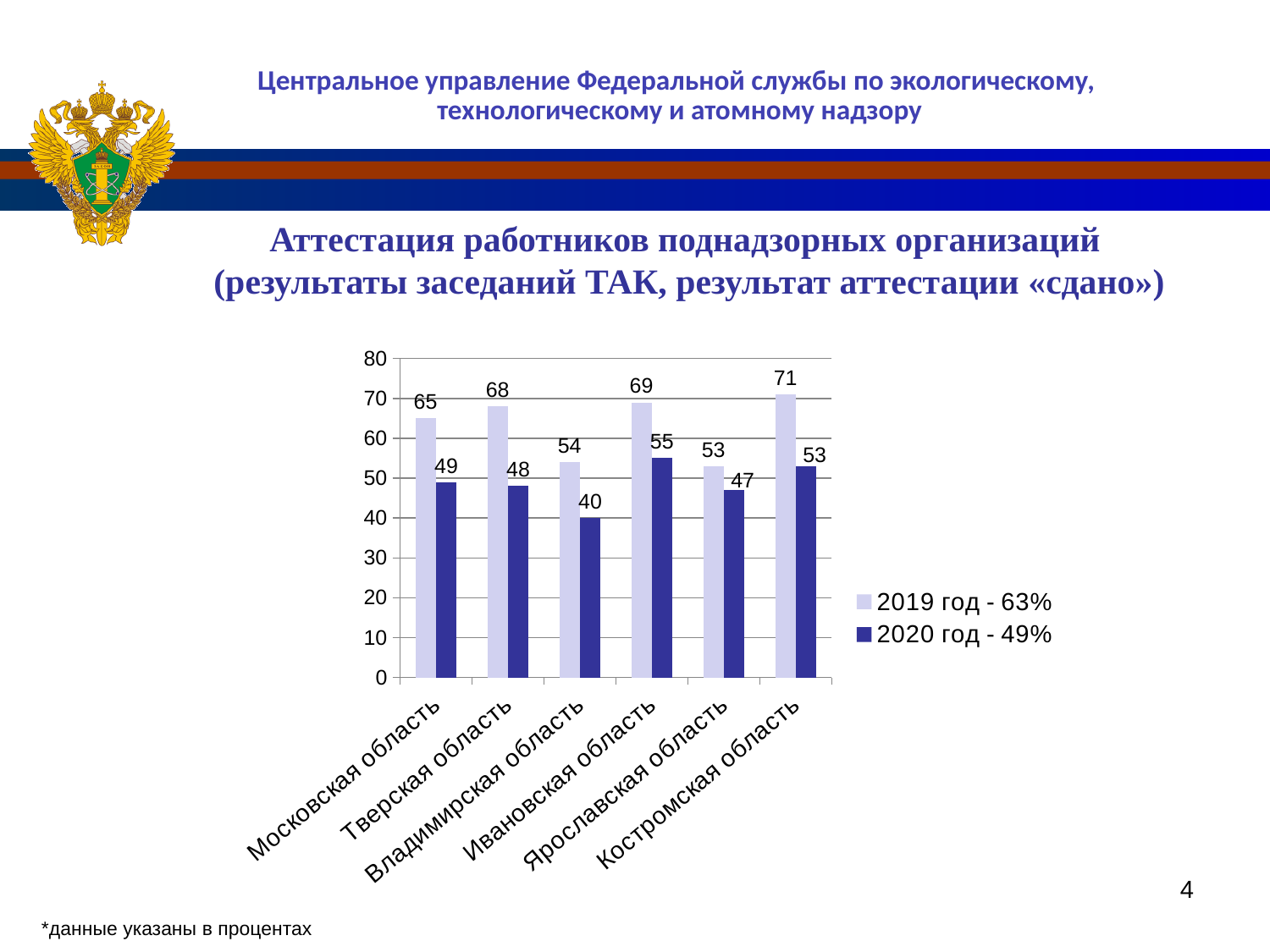
Which is larger for Ивановская область: the 2019 год - 63% value or the 2020 год - 49% value? 2019 год - 63% Which region has the highest value in the 2019 год - 63% series? Костромская область What is the value for Костромская область in the 2019 год - 63% series? 71 How many series does the legend list? 2 What is the difference between the 2019 and 2020 values for Тверская область? 20 What are the two legend entries of the chart? 2019 год - 63% and 2020 год - 49% What is the value for Владимирская область in the 2020 год - 49% series? 40 What is the value for Ярославская область in the 2020 год - 49% series? 47 How many regions are shown on the x axis? 6 Which region has the lowest value in the 2020 год - 49% series? Владимирская область What kind of chart is shown on the slide? bar chart What is the value for Московская область in the 2019 год - 63% series? 65